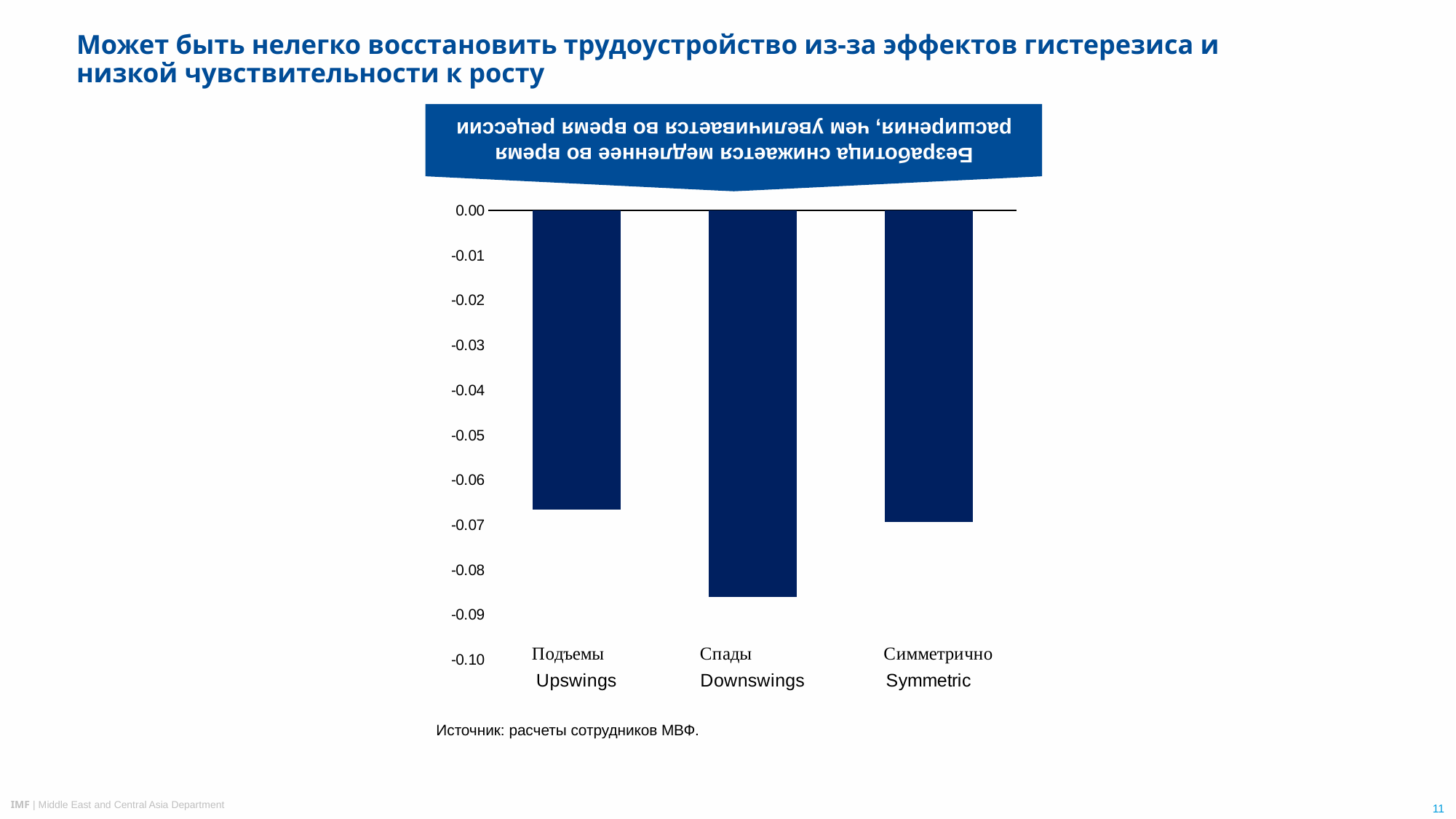
What kind of chart is shown on the slide? bar chart Is the value for Downswings greater or less than -0.08? less Which category has the lowest (most negative) value? Спады / Downswings Is the value for Symmetric greater or less than -0.08? greater Which bar is longer (more negative): Symmetric or Downswings? Downswings Is the value for Upswings greater or less than -0.06? less Which bar is longer (more negative): Upswings or Downswings? Downswings What is the lowest value shown on the vertical axis? -0.10 How many categories (bars) does the chart show? 3 What source is cited below the chart? Источник: расчеты сотрудников МВФ.